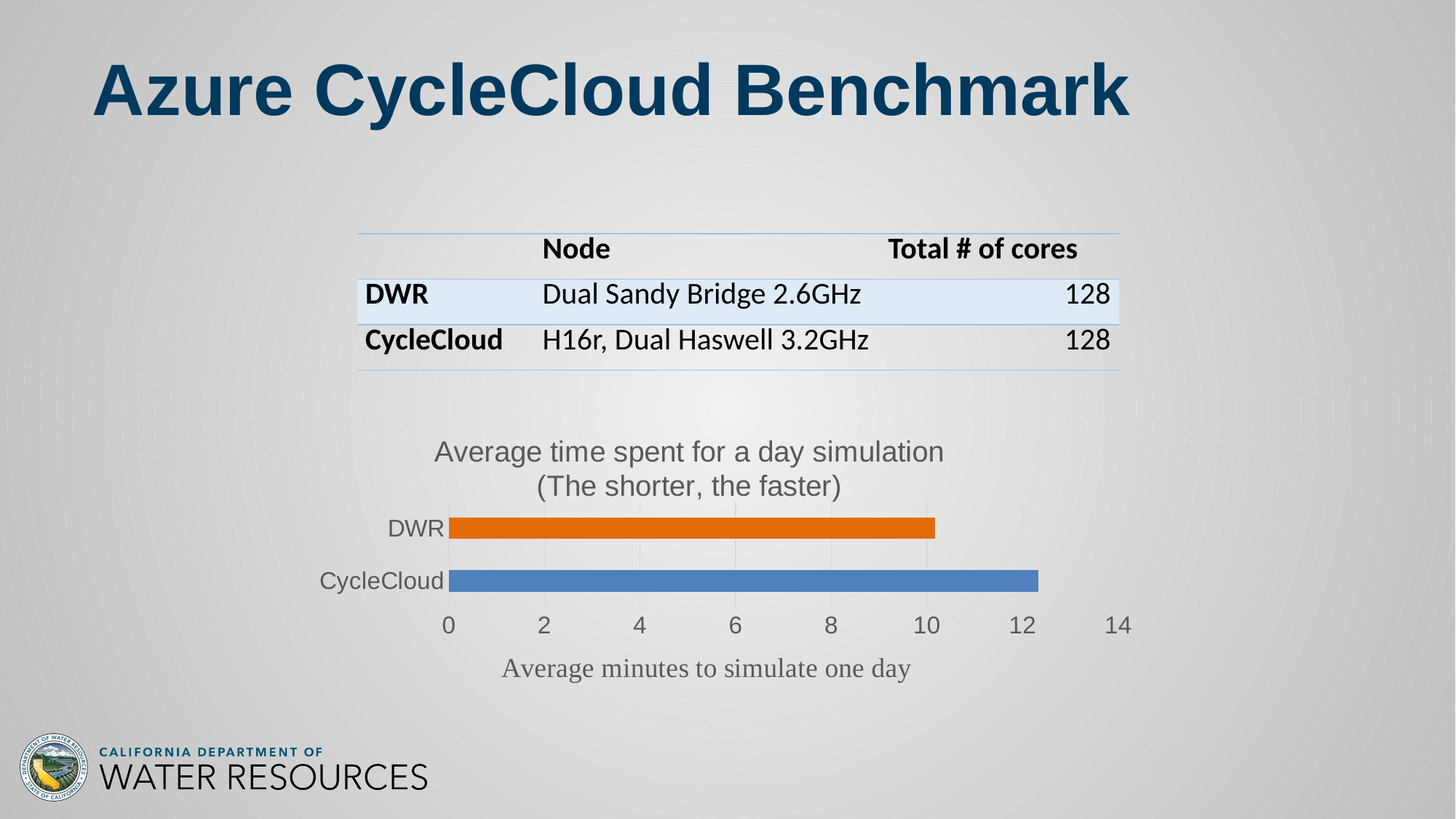
How many categories are plotted in the bar chart? 2 What is the title of the chart? Average time spent for a day simulation (The shorter, the faster) Which category has the shortest bar in the chart? DWR Is the value for DWR greater or less than 8? greater What is the label on the horizontal axis of the chart? Average minutes to simulate one day Is the value for DWR greater or less than 12? less Is the value for CycleCloud greater or less than 10? greater Which takes more average minutes to simulate one day, DWR or CycleCloud? CycleCloud What kind of chart is shown on the slide? bar chart Which category has the longest bar in the chart? CycleCloud